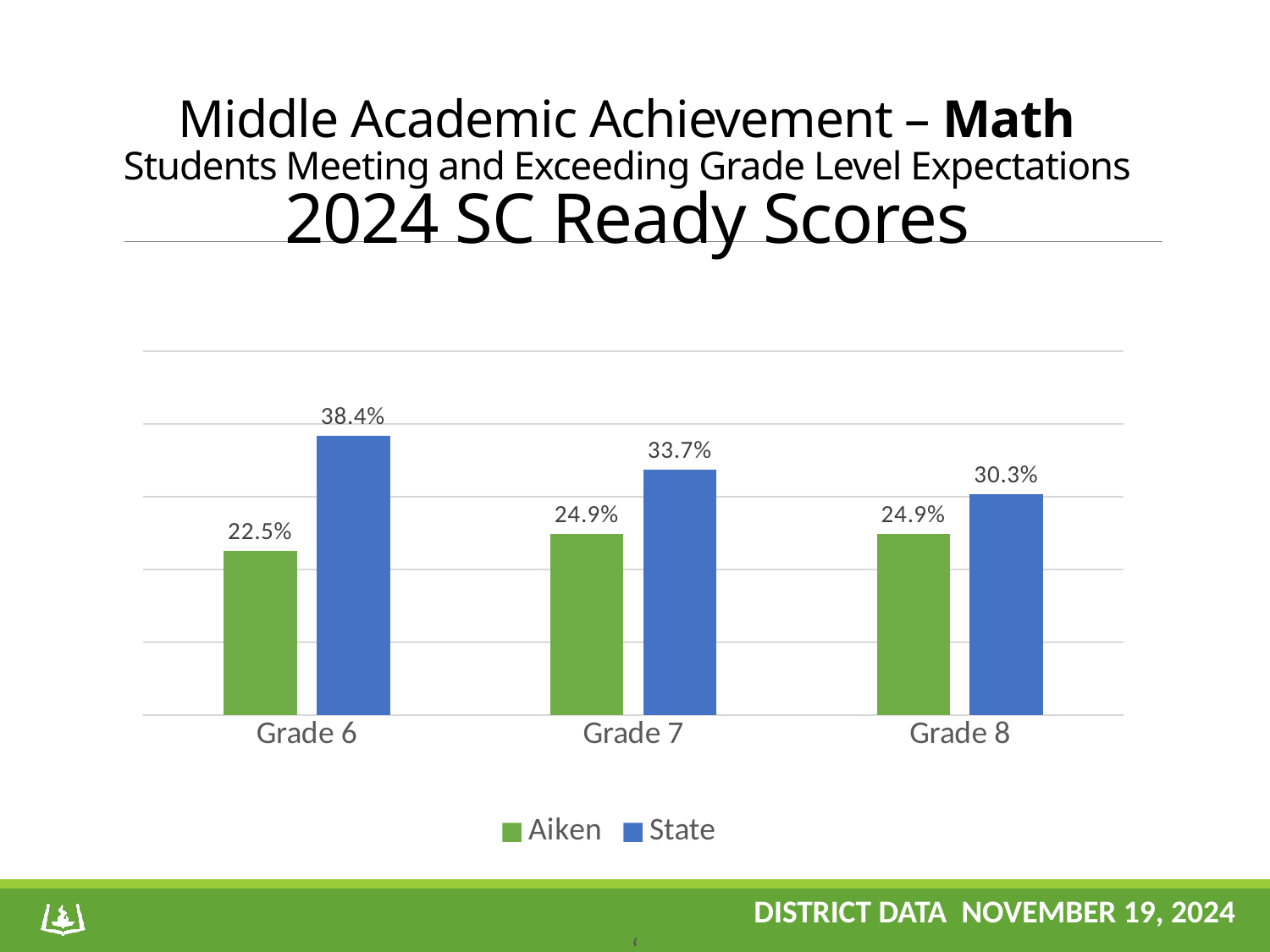
Which is larger for Grade 7, the Aiken value or the State value? State Which grade has the highest State value? Grade 6 What is the State value for Grade 7? 33.7% What is the difference between the State and Aiken values for Grade 6? 15.9% What is the Aiken value for Grade 6? 22.5% What kind of chart is shown on the slide? Bar chart What is the State value for Grade 8? 30.3% Which grade has the lowest Aiken value? Grade 6 What is the difference between the State and Aiken values for Grade 8? 5.4% How many grade categories are shown on the chart? 3 How many series does the legend list? 2 Do the State values rise or fall from Grade 6 to Grade 8? Fall